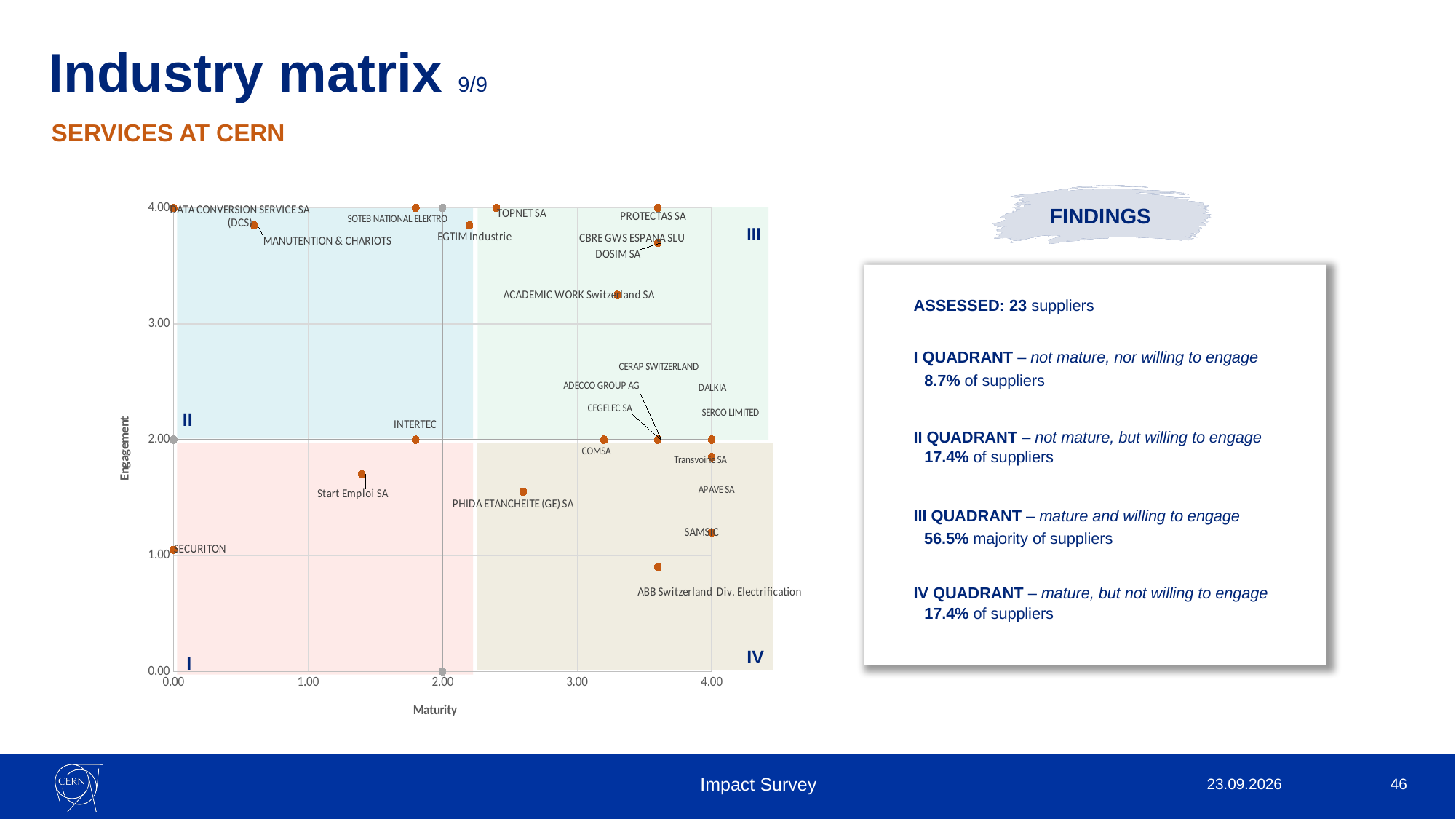
According to the findings, what percentage of suppliers fall in quadrant III? 56.5% Is the Maturity value for PHIDA ETANCHEITE (GE) SA greater or less than 2.00? greater What is the label of the vertical axis of the chart? Engagement How many suppliers were assessed in the industry matrix? 23 Which supplier has the lowest Engagement value in the chart? ABB Switzerland Div. Electrification Is the Engagement value for ACADEMIC WORK Switzerland SA greater or less than 3.00? greater Which supplier has the higher Engagement value, SECURITON or Start Emploi SA? Start Emploi SA Which supplier has the higher Maturity value, INTERTEC or COMSA? COMSA What is the label of the horizontal axis of the chart? Maturity What kind of chart is shown on the slide? scatter chart Is the Maturity value for Start Emploi SA greater or less than 2.00? less